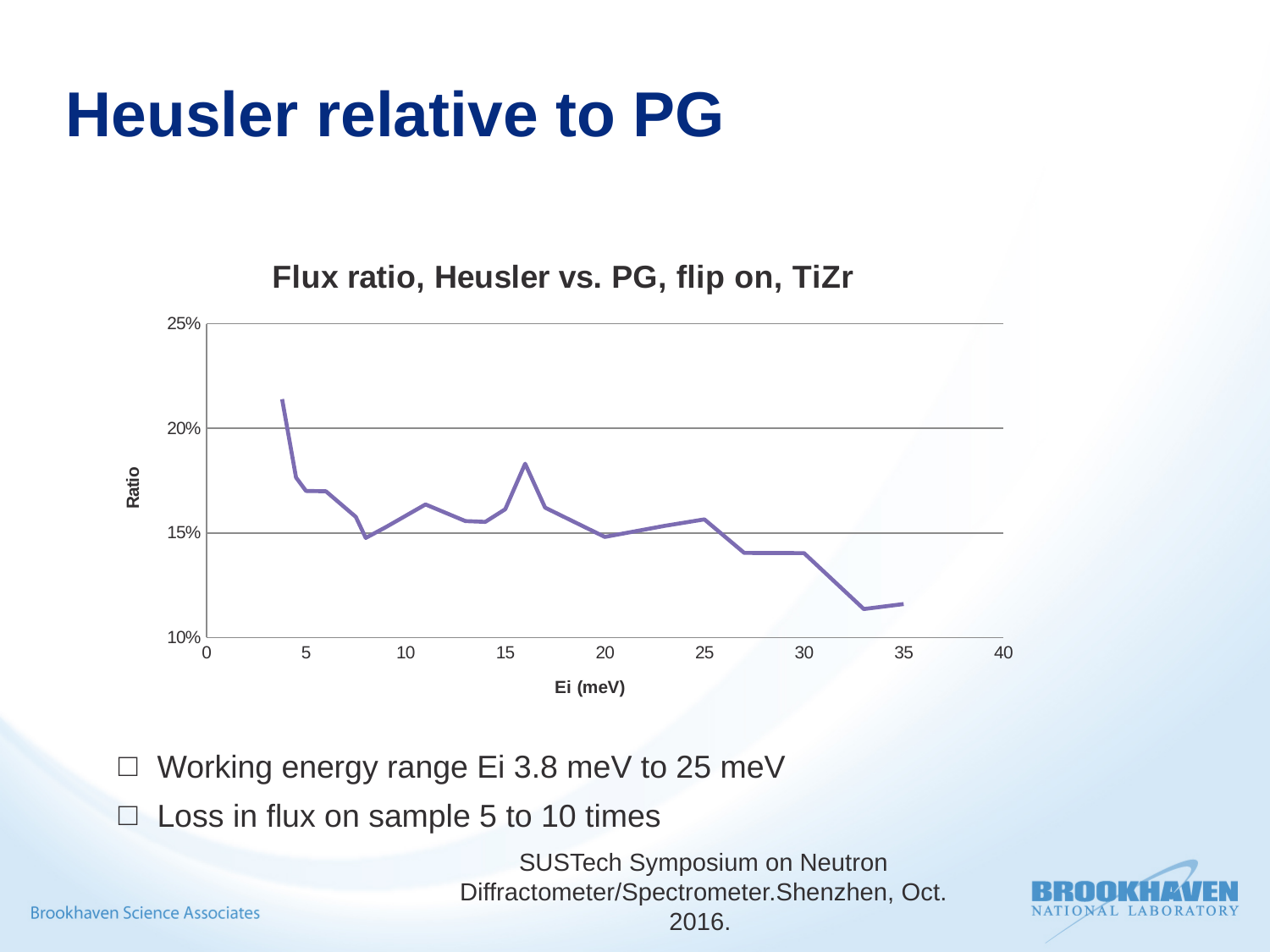
Is the ratio at Ei = 30 meV greater or less than 15%? less What kind of chart is shown on the slide? line chart Is the ratio at Ei = 35 meV greater or less than 15%? less Is the ratio at the first plotted point (near Ei = 4 meV) greater or less than 20%? greater Is the ratio higher at Ei = 10 meV or at Ei = 30 meV? Ei = 10 meV Is the ratio higher at Ei = 16 meV or at Ei = 20 meV? Ei = 16 meV What is the label of the x axis of the chart? Ei (meV) Is the ratio higher at Ei = 5 meV or at Ei = 35 meV? Ei = 5 meV What is the title of the chart? Flux ratio, Heusler vs. PG, flip on, TiZr Overall, does the ratio rise or fall as Ei increases from left to right? fall